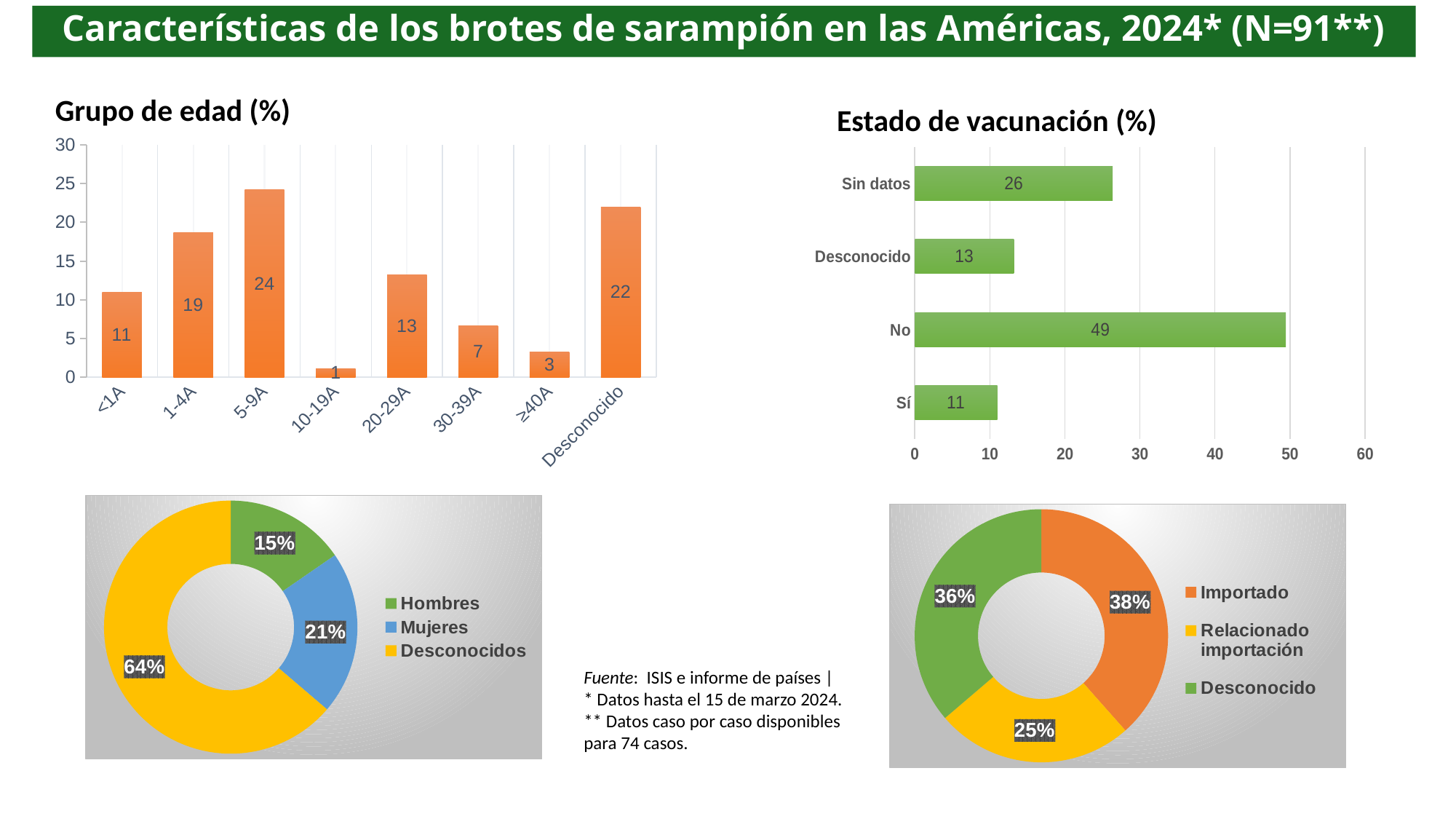
In the bottom-left doughnut chart, what share is 'Mujeres'? 21% In the 'Estado de vacunación (%)' chart, which is larger, 'Sin datos' or 'Desconocido'? Sin datos How many entries does the legend of the bottom-right doughnut chart list? 3 In the 'Estado de vacunación (%)' chart, which category has the highest value? No In the 'Grupo de edad (%)' chart, what is the value for the 5-9A age group? 24 In the 'Estado de vacunación (%)' chart, what is the value for 'No'? 49 What kind of chart is the 'Estado de vacunación (%)' chart? Bar chart In the 'Grupo de edad (%)' chart, how many age-group categories are shown? 8 In the 'Grupo de edad (%)' chart, which age group has the lowest value? 10-19A In the 'Grupo de edad (%)' chart, what is the difference between the values for 1-4A and 20-29A? 6 In the bottom-right doughnut chart, what share is 'Importado'? 38% In the bottom-left doughnut chart, which category has the largest share? Desconocidos